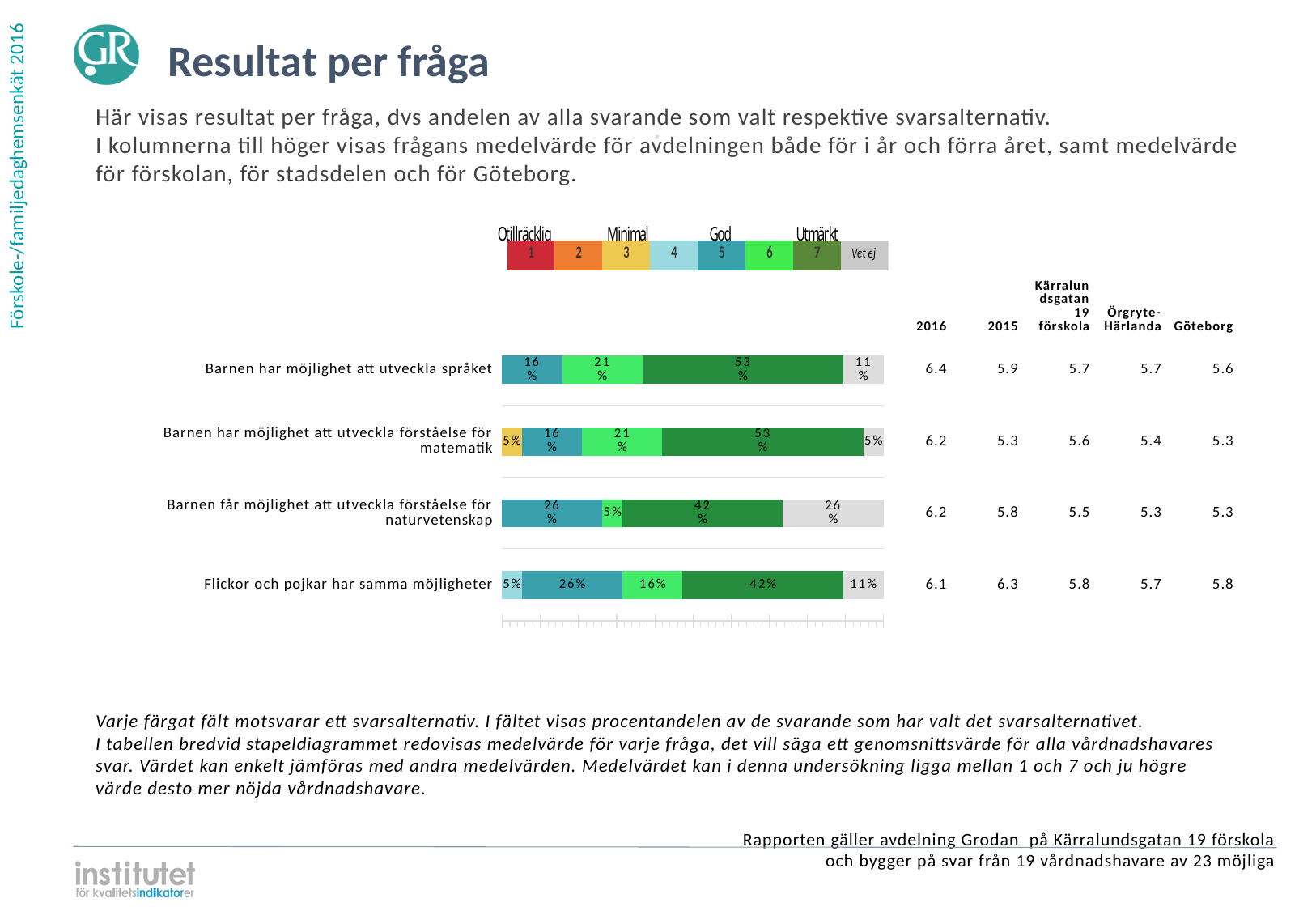
Which has a larger share of answer 6: 'Barnen har möjlighet att utveckla språket' or 'Barnen får möjlighet att utveckla förståelse för naturvetenskap'? Barnen har möjlighet att utveckla språket What is the 2016 mean value shown for 'Barnen har möjlighet att utveckla språket'? 6.4 What is the 'Vet ej' share for 'Barnen får möjlighet att utveckla förståelse för naturvetenskap'? 26% How many percentage points higher is the share of 7 for 'Barnen har möjlighet att utveckla språket' than for 'Barnen får möjlighet att utveckla förståelse för naturvetenskap'? 11 percentage points How many questions (categories) are plotted in the bar chart? 4 How many answer options does the legend above the chart list? 8 What percentage chose 5 for 'Flickor och pojkar har samma möjligheter'? 26% Which question has the largest 'Vet ej' share? Barnen får möjlighet att utveckla förståelse för naturvetenskap What kind of chart is shown on the slide? Stacked bar chart What is the combined share of answers 5, 6 and 7 for 'Barnen har möjlighet att utveckla förståelse för matematik'? 90% What label does the legend give to answer option 7? Utmärkt What percentage of respondents chose 7 for 'Barnen har möjlighet att utveckla språket'? 53%